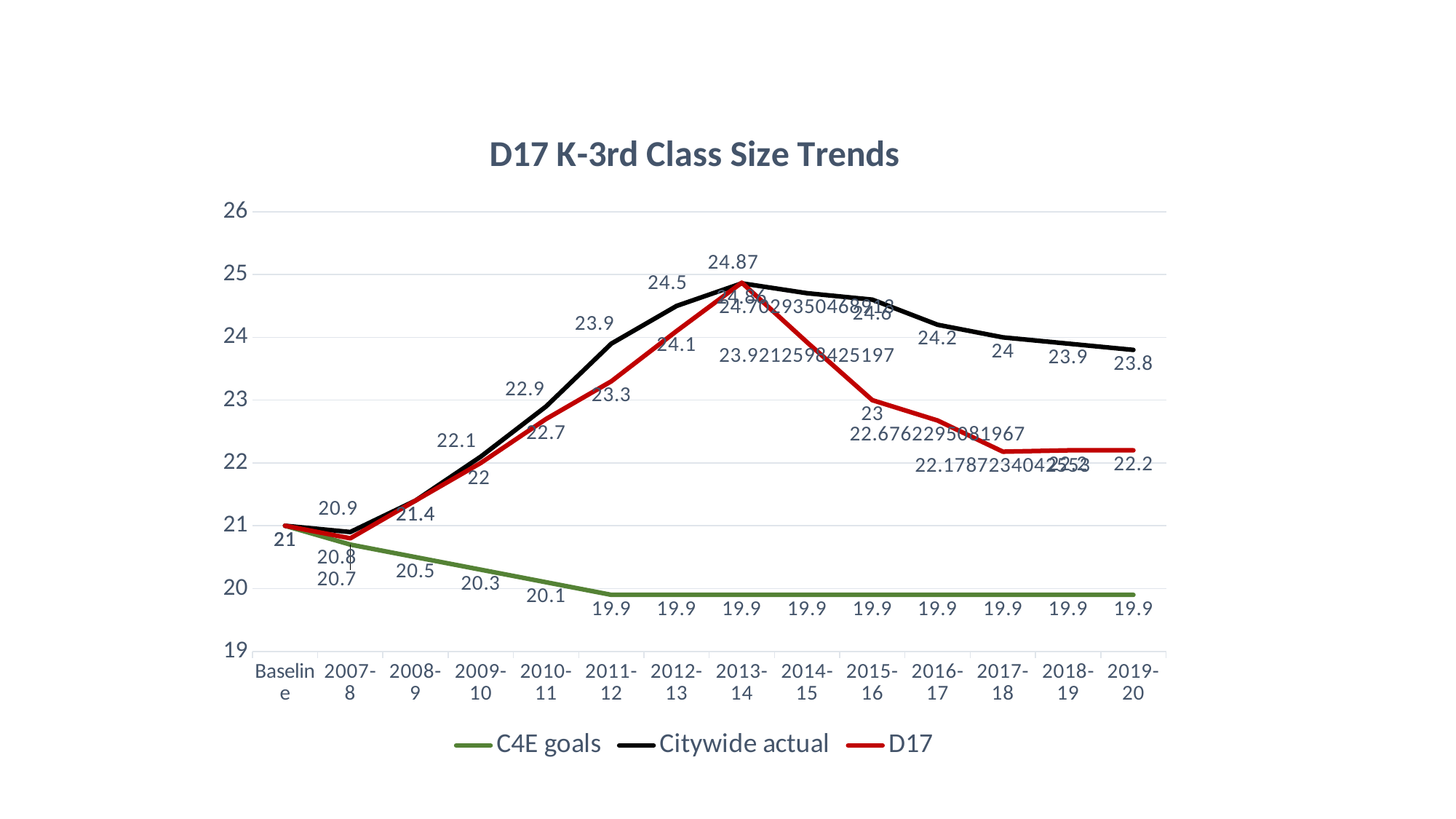
Is the Citywide actual value for 2014-15 greater or less than 24? greater Do the C4E goals values rise or fall from Baseline to 2011-12? fall In which year is the Citywide actual series at its highest? 2013-14 What is the C4E goals value for 2019-20? 19.9 How many series does the legend list? 3 What is the Citywide actual value for 2010-11? 22.9 How many categories are shown on the x axis? 14 What kind of chart is shown on the slide? line chart In 2012-13, which is larger: Citywide actual or D17? Citywide actual What is the difference between the Citywide actual and D17 values in 2019-20? 1.6 What is the D17 value for 2015-16? 23 What is the Citywide actual value for 2013-14? 24.86